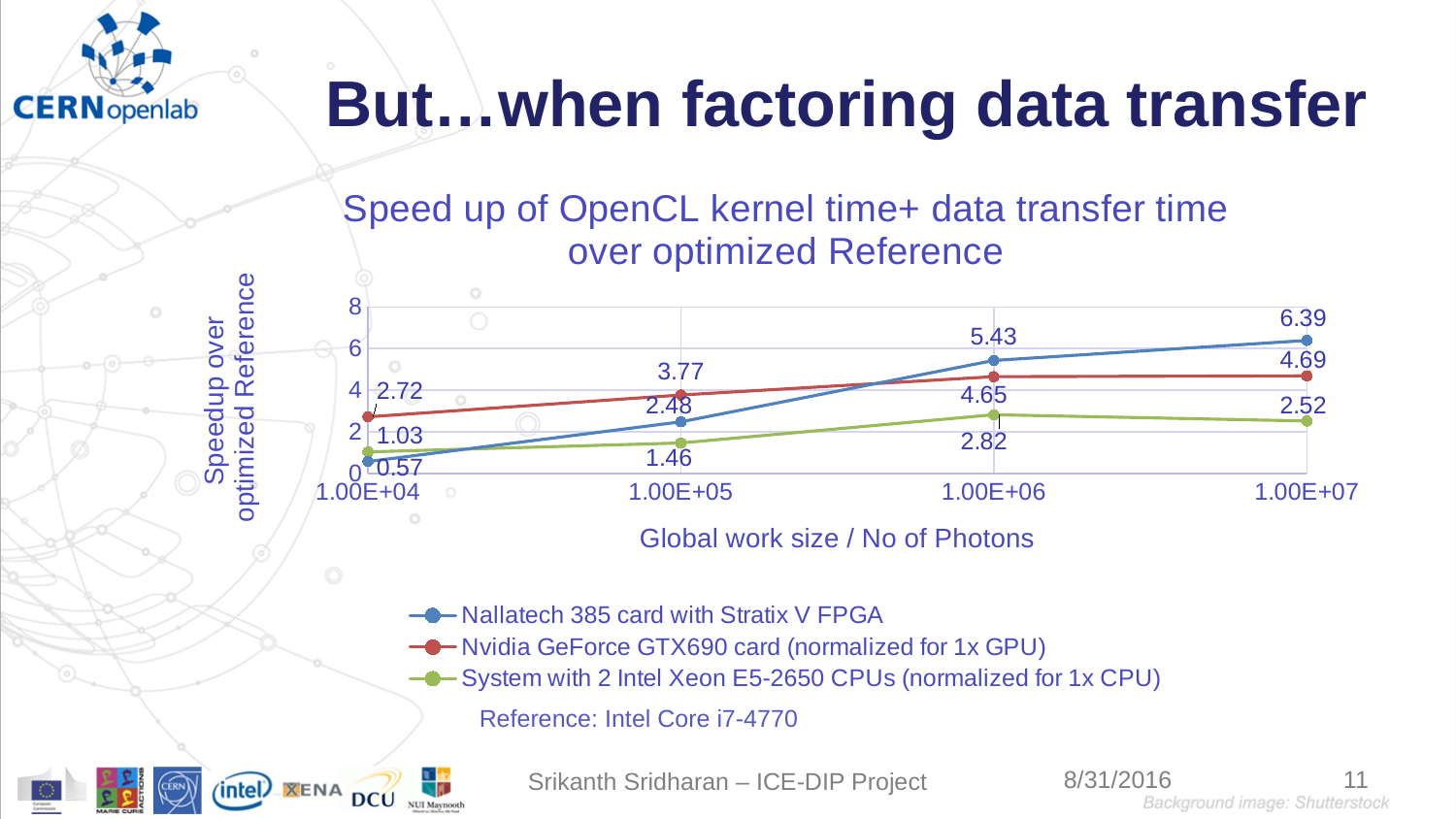
At a global work size of 1.00E+05, which is larger: the speedup of the Nvidia GeForce GTX690 card or the Nallatech 385 FPGA card? Nvidia GeForce GTX690 card How many series does the legend list? 3 What is the speedup for the Nvidia GeForce GTX690 card at a global work size of 1.00E+04? 2.72 Which series has the lowest speedup at a global work size of 1.00E+04? Nallatech 385 card with Stratix V FPGA What is the label of the x axis? Global work size / No of Photons What is the speedup for the System with 2 Intel Xeon E5-2650 CPUs at a global work size of 1.00E+06? 2.82 What is the difference between the Nallatech 385 FPGA speedup and the Nvidia GTX690 speedup at a global work size of 1.00E+06? 0.78 How many global work size points are plotted along the x axis? 4 Does the speedup of the Nallatech 385 card with Stratix V FPGA rise or fall as the global work size increases? rise Which series has the highest speedup at a global work size of 1.00E+07? Nallatech 385 card with Stratix V FPGA What type of chart is shown on the slide? line chart What is the speedup for the Nallatech 385 card with Stratix V FPGA at a global work size of 1.00E+07? 6.39